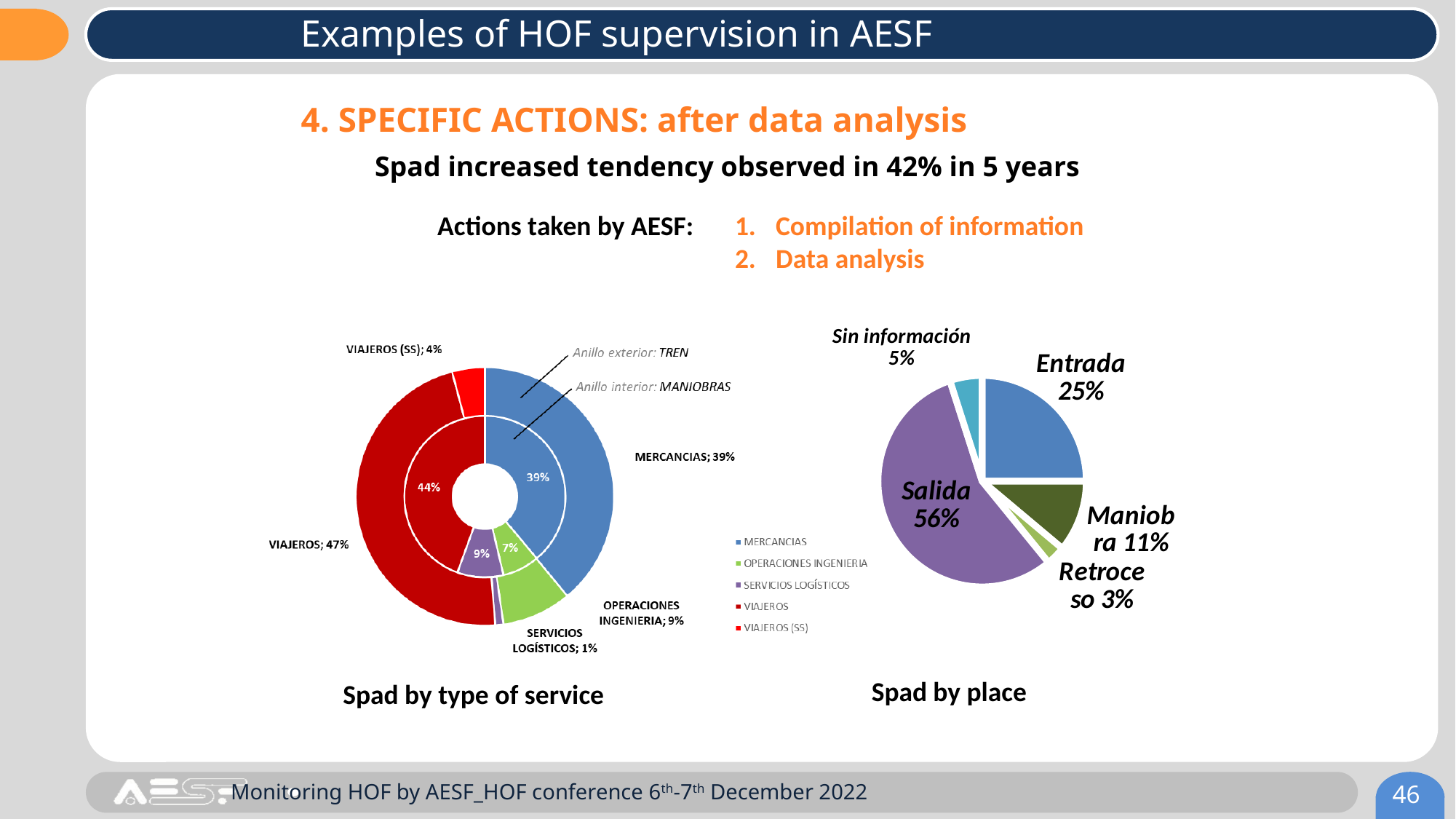
In the 'Spad by place' chart, how many categories are shown? 5 In the 'Spad by place' chart, what share does Salida have? 56% In the 'Spad by type of service' chart, what is the outer-ring value for MERCANCIAS? 39% In the 'Spad by type of service' chart, which category has the smallest outer-ring value? SERVICIOS LOGÍSTICOS In the 'Spad by place' chart, which category has the largest share? Salida In the 'Spad by type of service' chart, what is the outer-ring value for VIAJEROS? 47% In the 'Spad by place' chart, what is the difference between the shares of Salida and Entrada? 31% In the 'Spad by place' chart, which category has the smallest share? Retroceso What kind of chart is 'Spad by place'? Pie chart In the 'Spad by type of service' chart, how many entries does the legend list? 5 In the 'Spad by type of service' chart, which is larger in the outer ring: OPERACIONES INGENIERIA or VIAJEROS (SS)? OPERACIONES INGENIERIA In the 'Spad by place' chart, what share does Entrada have? 25%